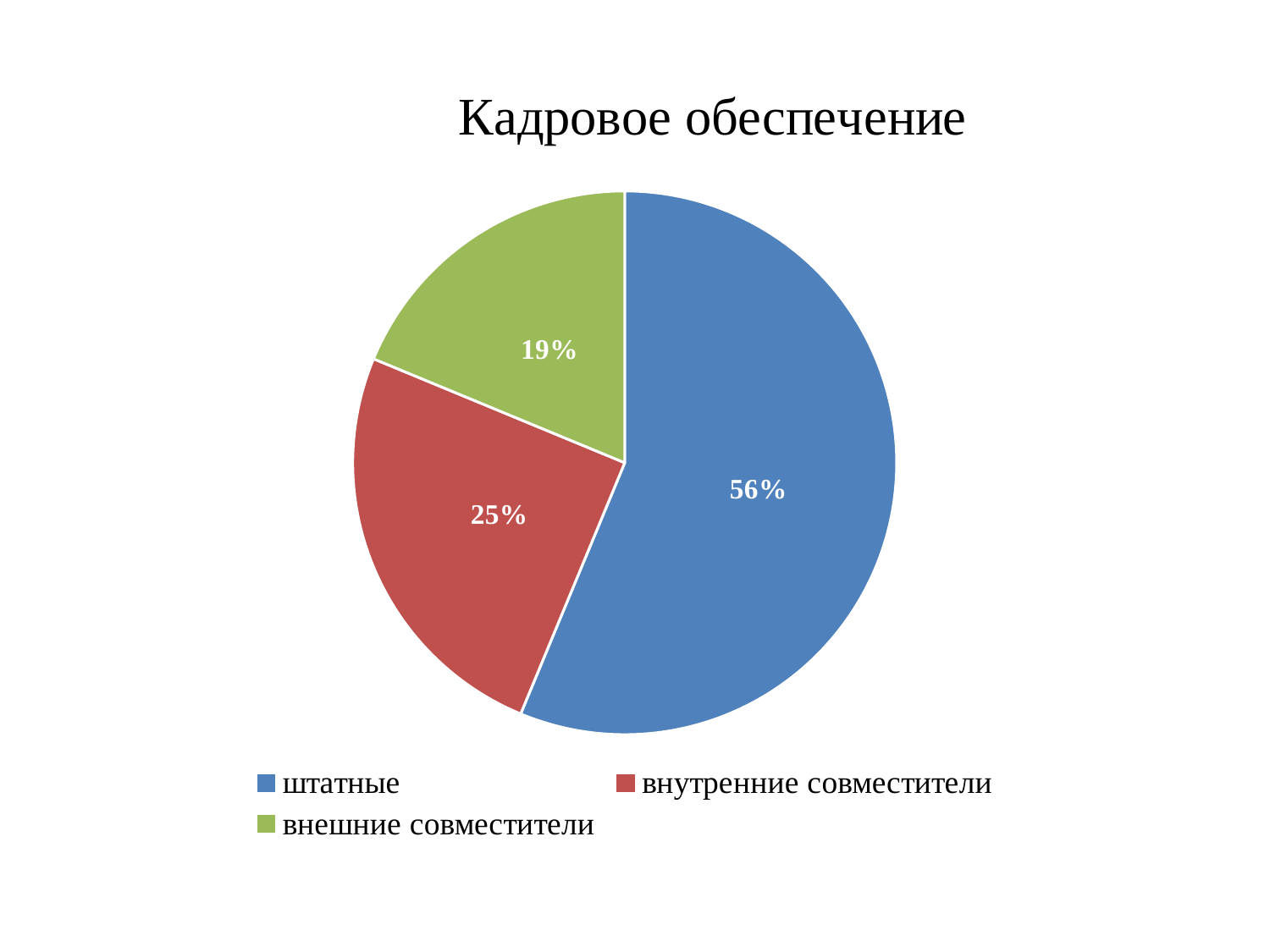
What is the difference in percentage points between внутренние совместители and внешние совместители? 6 What colour is the slice for штатные? blue What share of the pie is labelled for внешние совместители? 19% How many categories does the pie chart show? 3 Which category has the smallest slice of the pie? внешние совместители What is the title of the chart? Кадровое обеспечение What share of the pie is labelled for внутренние совместители? 25% Which category has the largest slice of the pie? штатные Which is larger, the slice for внутренние совместители or the slice for внешние совместители? внутренние совместители What share of the pie is labelled for штатные? 56% What kind of chart is shown on the slide? pie chart What is the difference in percentage points between штатные and внутренние совместители? 31